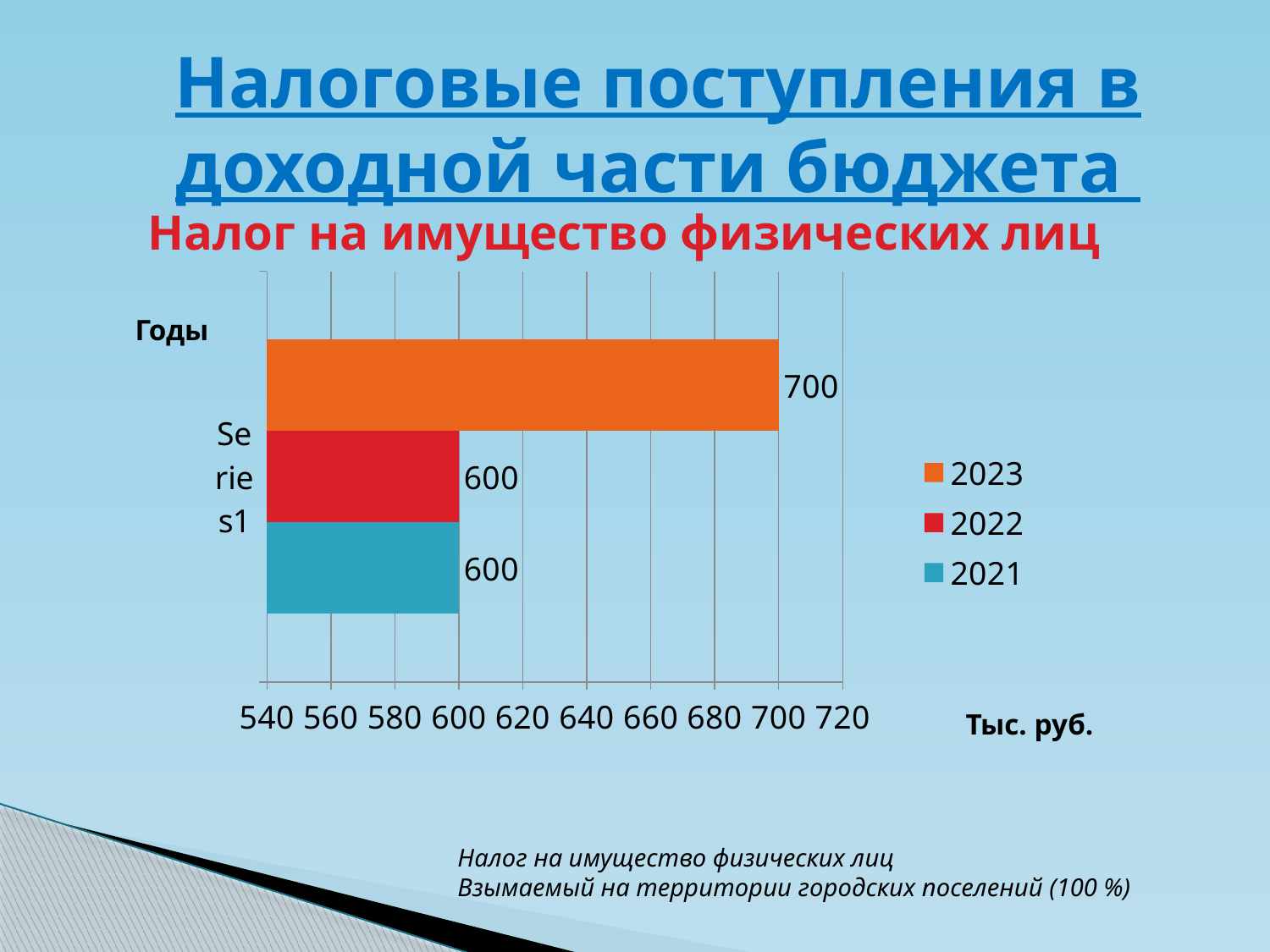
What is the difference between the values for 2023 and 2022? 100 What unit is shown for the values on the chart's axis? Тыс. руб. What is the value for 2022 in the chart? 600 What is the title of the chart? Налог на имущество физических лиц Which year has the highest value in the chart? 2023 Is the value for 2023 greater or less than 680? greater Is the value for 2022 greater or less than 640? less What kind of chart is shown on the slide? bar chart What is the value for 2021 in the chart? 600 What is the value for 2023 in the chart? 700 How many series does the legend list? 3 Which is larger, the value for 2023 or the value for 2021? 2023